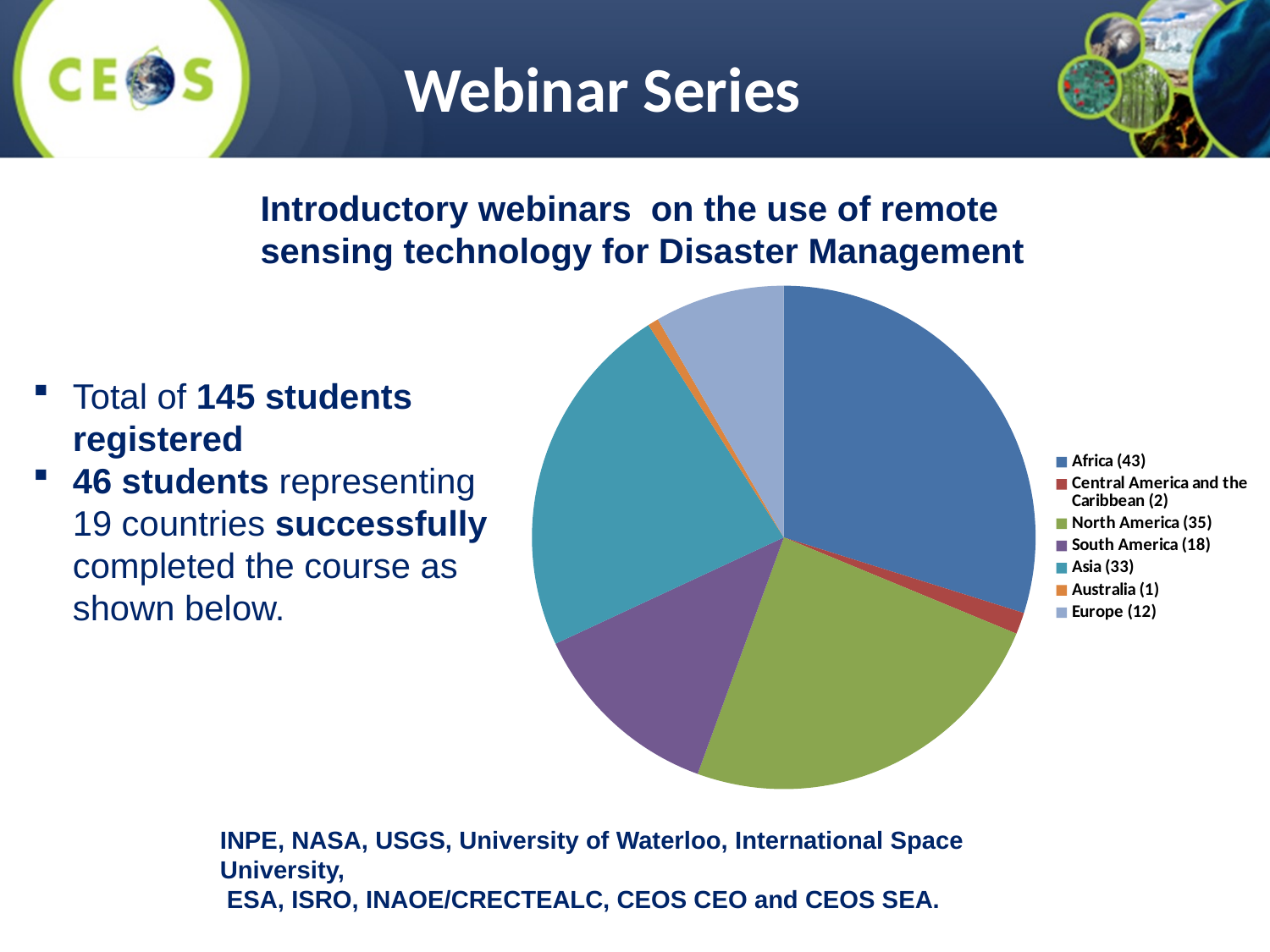
Which region has the largest slice of the pie chart? Africa What kind of chart is shown on the slide? pie chart What is the value shown for Central America and the Caribbean in the pie chart legend? 2 Which is larger, the value for North America or the value for Asia? North America What is the value shown for Europe in the pie chart legend? 12 What is the value shown for Africa in the pie chart legend? 43 What colour is the slice for South America in the pie chart? purple How many regions does the pie chart's legend list? 7 What is the difference between the values for Africa and North America? 8 What is the value shown for Asia in the pie chart legend? 33 What is the difference between the values for Asia and South America? 15 Which region has the smallest slice of the pie chart? Australia